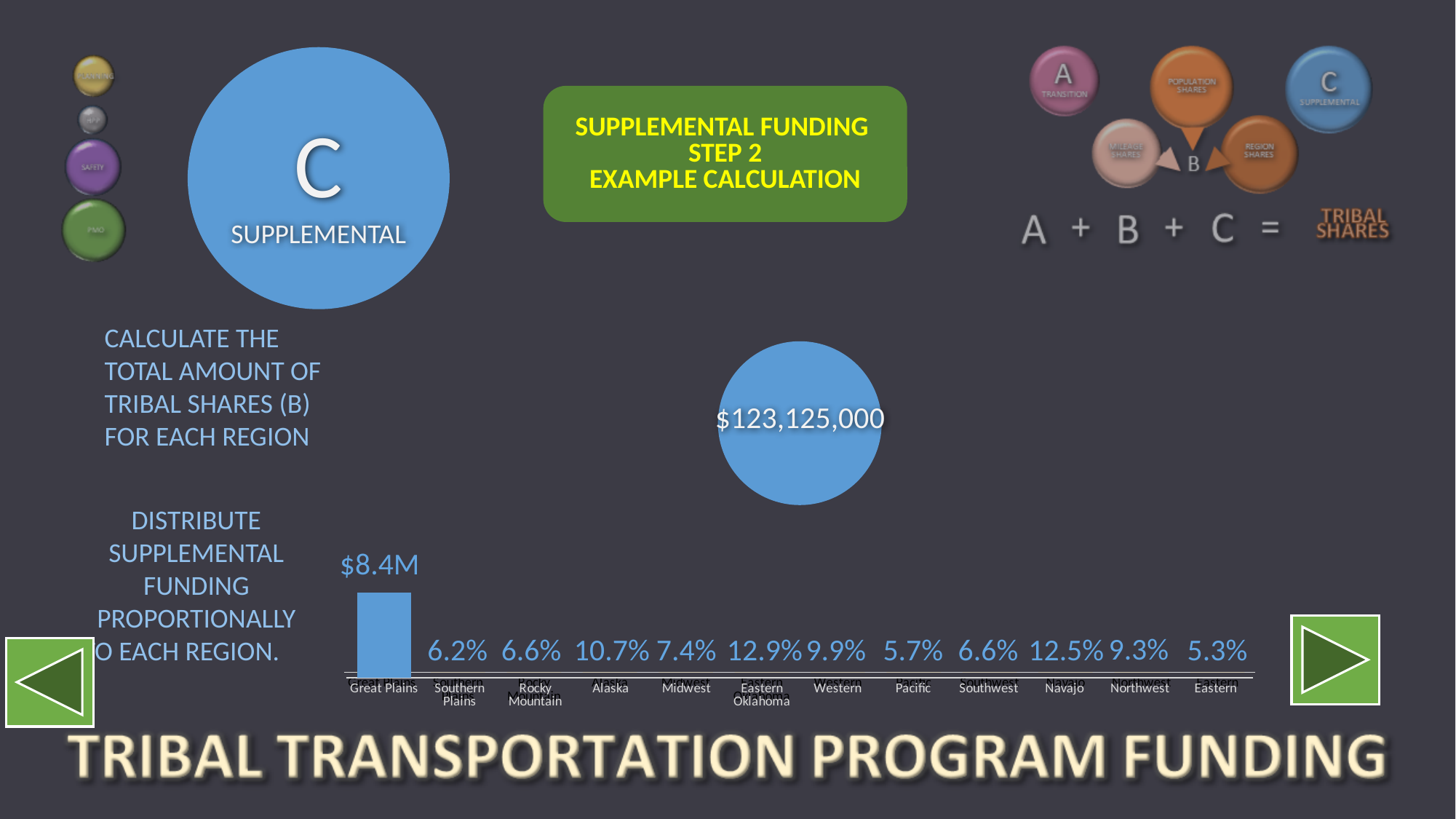
What label is shown above the Great Plains bar? $8.4M What percentage is shown for Alaska? 10.7% What percentage is shown for Navajo? 12.5% Which region is the first category on the x axis of the chart? Great Plains How many regions are listed along the x axis of the chart? 12 What kind of chart is shown at the bottom of the slide? Bar chart What percentage is shown for Pacific? 5.7% What is the difference between the percentages shown for Eastern Oklahoma and Navajo? 0.4% Which region has the lowest percentage label shown on the chart? Eastern Which has a larger percentage label, Western or Northwest? Western Which region has the highest percentage label shown on the chart? Eastern Oklahoma What percentage is shown for Eastern Oklahoma? 12.9%